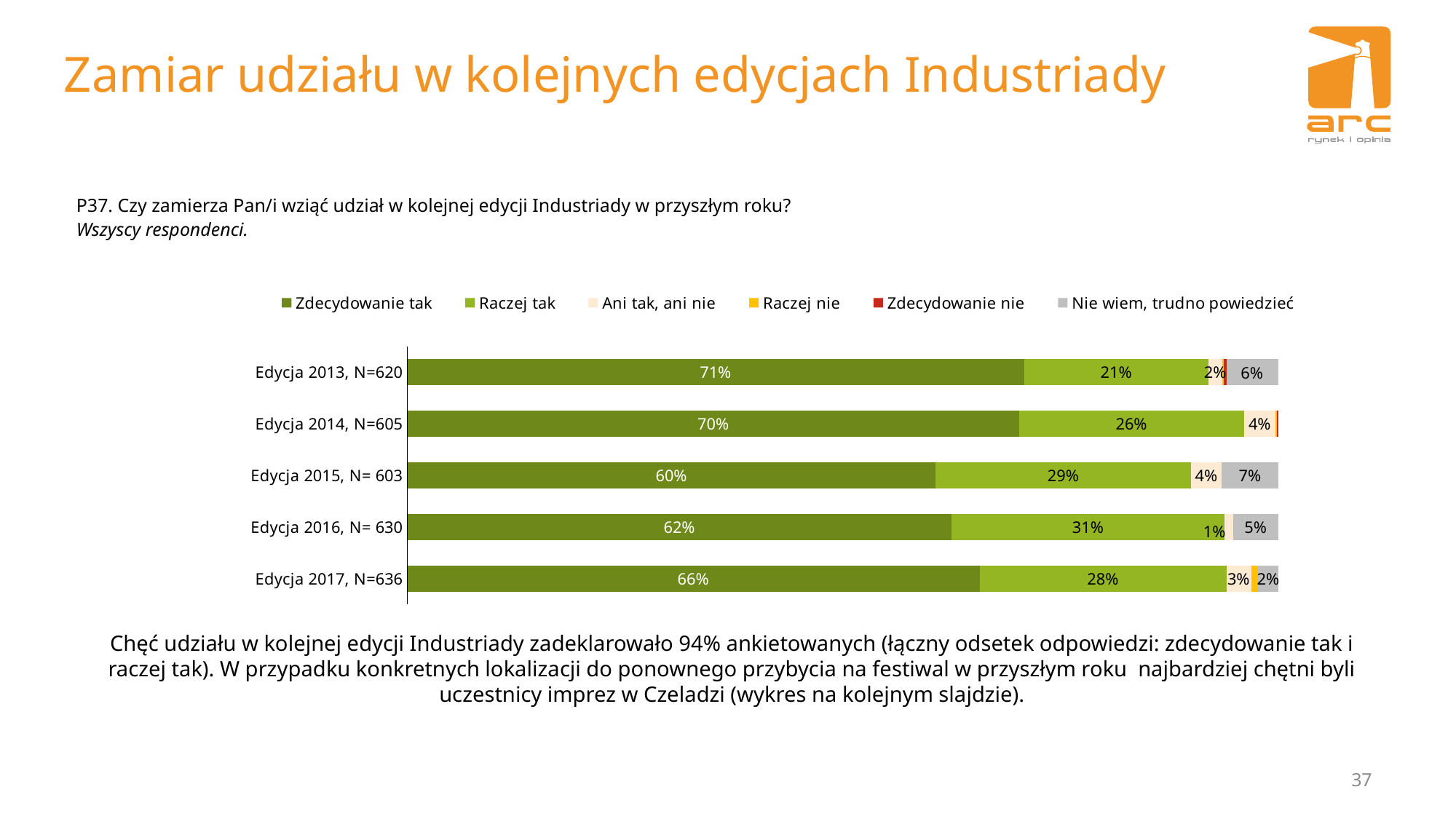
How many editions (categories) are shown on the chart? 5 How many series does the legend list? 6 What is the value of 'Zdecydowanie tak' for Edycja 2013, N=620? 71% What kind of chart is shown on the slide? Stacked bar chart Which edition has the lowest 'Zdecydowanie tak' value? Edycja 2015, N= 603 What is the value of 'Raczej tak' for Edycja 2016, N= 630? 31% What is the value of 'Nie wiem, trudno powiedzieć' for Edycja 2015, N= 603? 7% What is the value of 'Ani tak, ani nie' for Edycja 2017, N=636? 3% Which edition has the highest 'Zdecydowanie tak' value? Edycja 2013, N=620 What is the difference between the 'Zdecydowanie tak' values for Edycja 2013, N=620 and Edycja 2015, N= 603? 11% Which legend entry is shown in grey? Nie wiem, trudno powiedzieć Which is larger: 'Raczej tak' for Edycja 2014, N=605 or for Edycja 2017, N=636? Edycja 2017, N=636